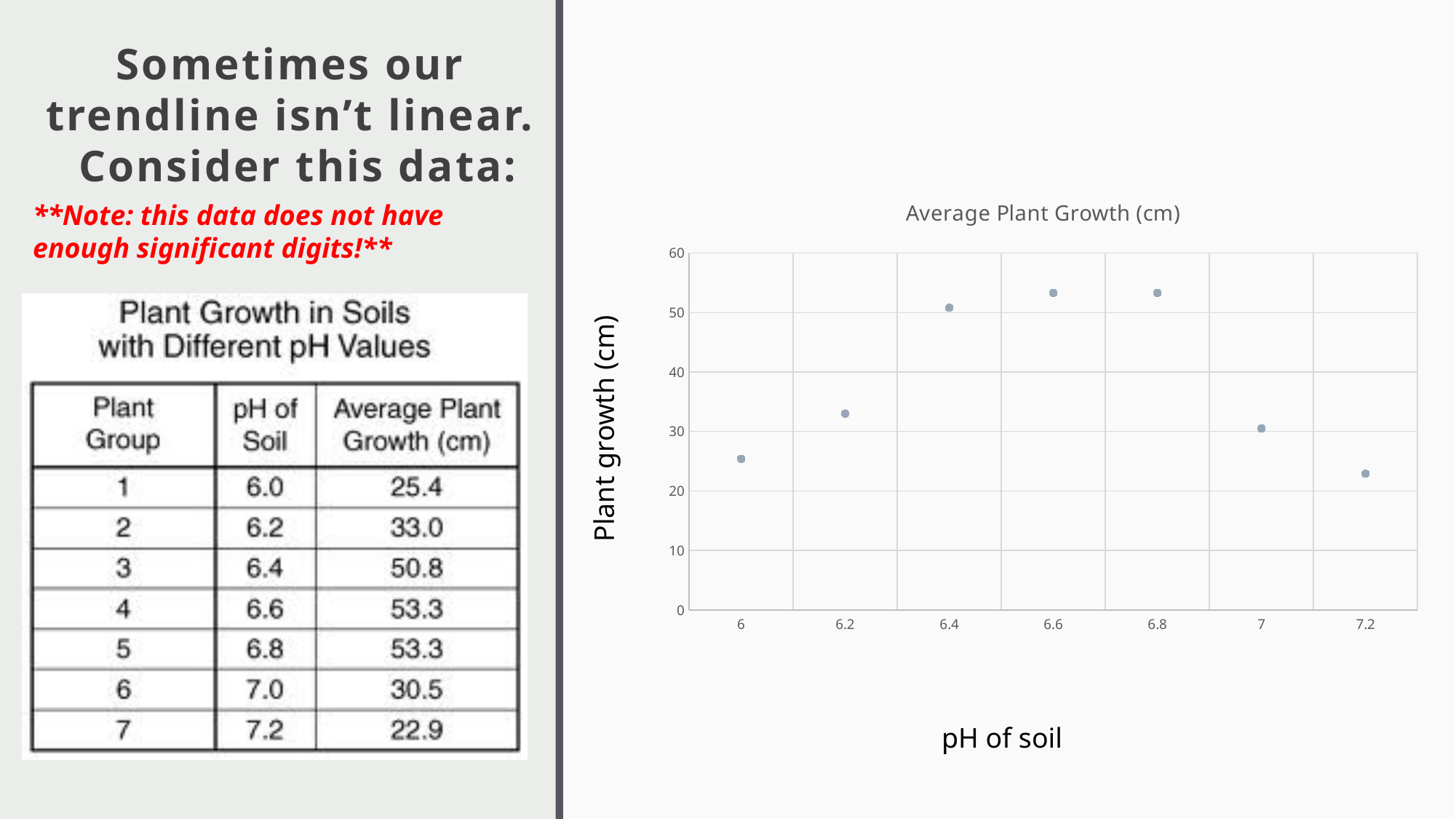
According to the slide, what is the average plant growth at a soil pH of 6.4? 50.8 What is the title of the chart? Average Plant Growth (cm) Is the plant growth value at pH 6.6 greater or less than 50? greater Which has a higher plant growth value, pH 6.2 or pH 7? pH 6.2 Do the plotted plant growth values rise or fall as pH increases from 6.8 to 7.2? fall At which soil pH is the plotted plant growth lowest? 7.2 According to the slide, what is the average plant growth at a soil pH of 7.2? 22.9 What is the difference in average plant growth between pH 6.4 and pH 6.0, using the values printed on the slide? 25.4 What is the label of the x axis of the chart? pH of soil How many data points are plotted on the chart? 7 What kind of chart is shown on the slide? scatter chart Is the plant growth value at pH 6 greater or less than 30? less